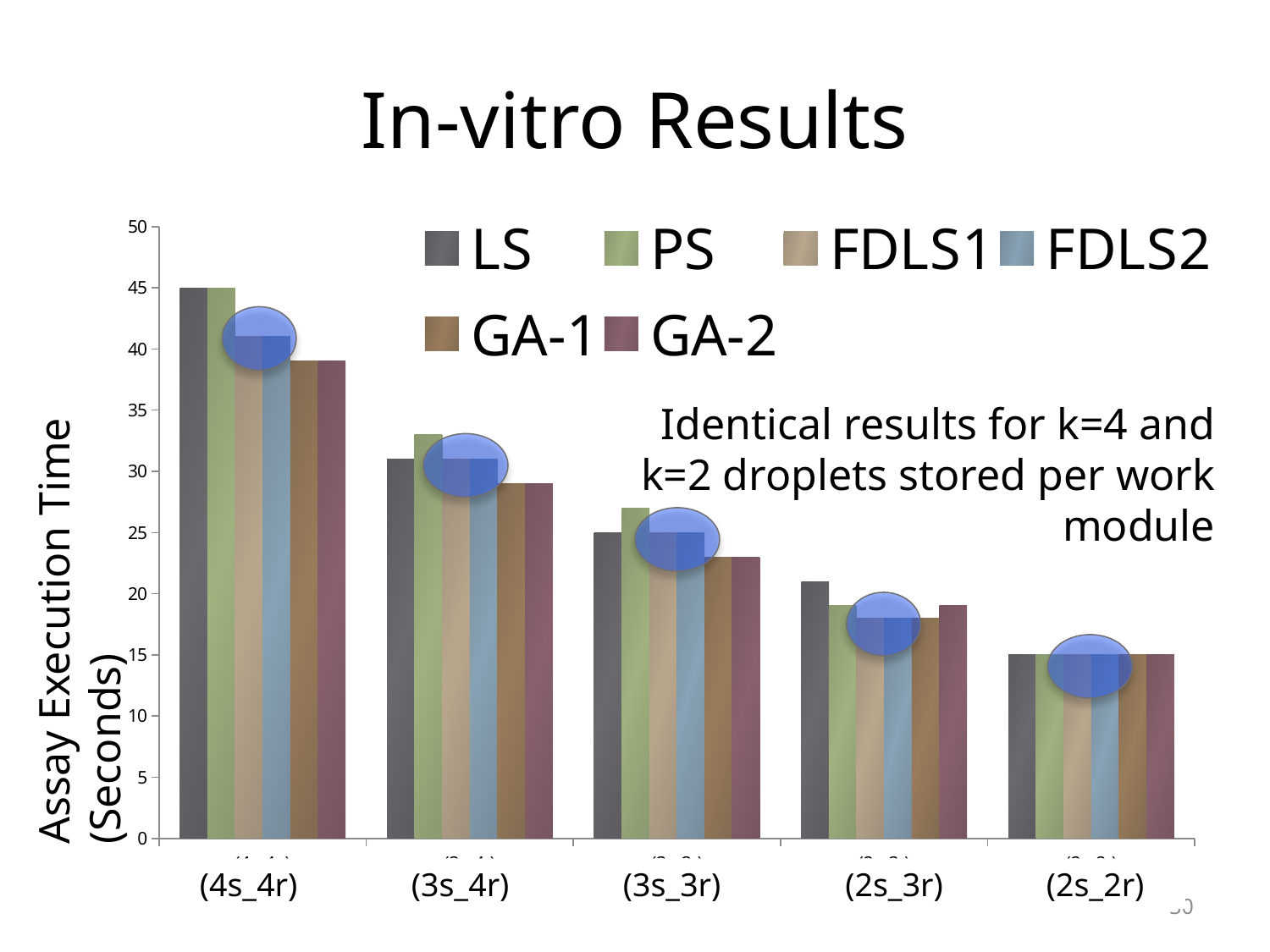
Is the value for PS at (3s_4r) greater or less than 30? greater How many categories are shown on the x axis? 5 Which is larger at (4s_4r), the LS value or the GA-2 value? LS Do the LS values rise or fall moving from (4s_4r) to (2s_2r) along the x axis? fall How many series does the legend list? 6 What kind of chart is shown on the slide? bar chart What is the Assay Execution Time for LS at (4s_4r)? 45 Is the value for GA-2 at (3s_3r) greater or less than 25? less Is the value for GA-1 at (4s_4r) greater or less than 40? less Which category has the highest LS value? (4s_4r) What is the Assay Execution Time for LS at (2s_2r)? 15 Which is larger at (3s_3r), the PS value or the LS value? PS